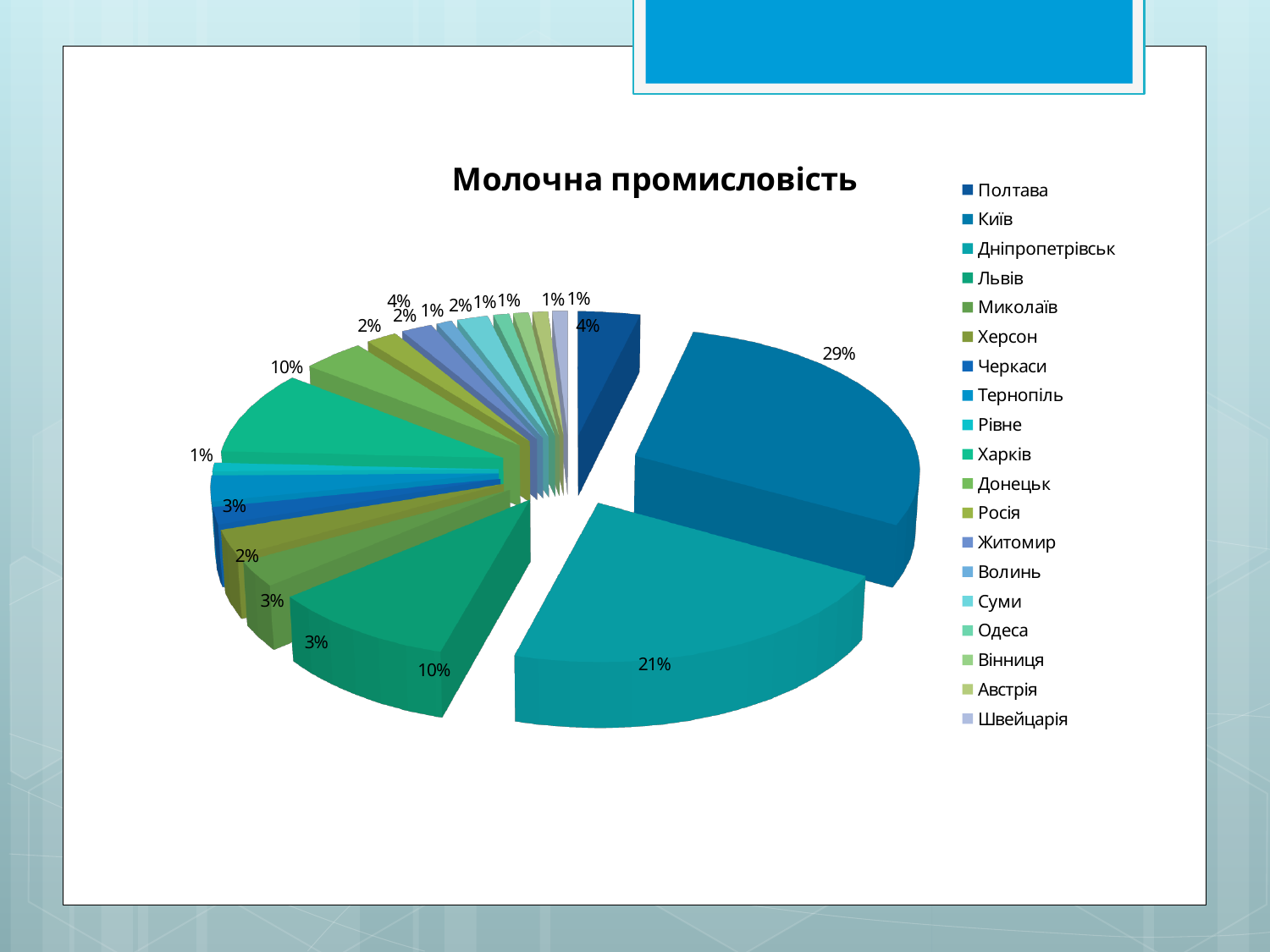
What share of the pie does Полтава have? 4% What share of the pie does Дніпропетрівськ have? 21% What is the title of the chart? Молочна промисловість Which category has the largest slice of the pie? Київ How many categories does the legend list? 19 What share of the pie does Київ have? 29% What kind of chart is shown on the slide? pie chart Which slice is larger, Дніпропетрівськ or Львів? Дніпропетрівськ Which category is listed first in the legend? Полтава What is the difference in percentage points between the Київ slice and the Дніпропетрівськ slice? 8